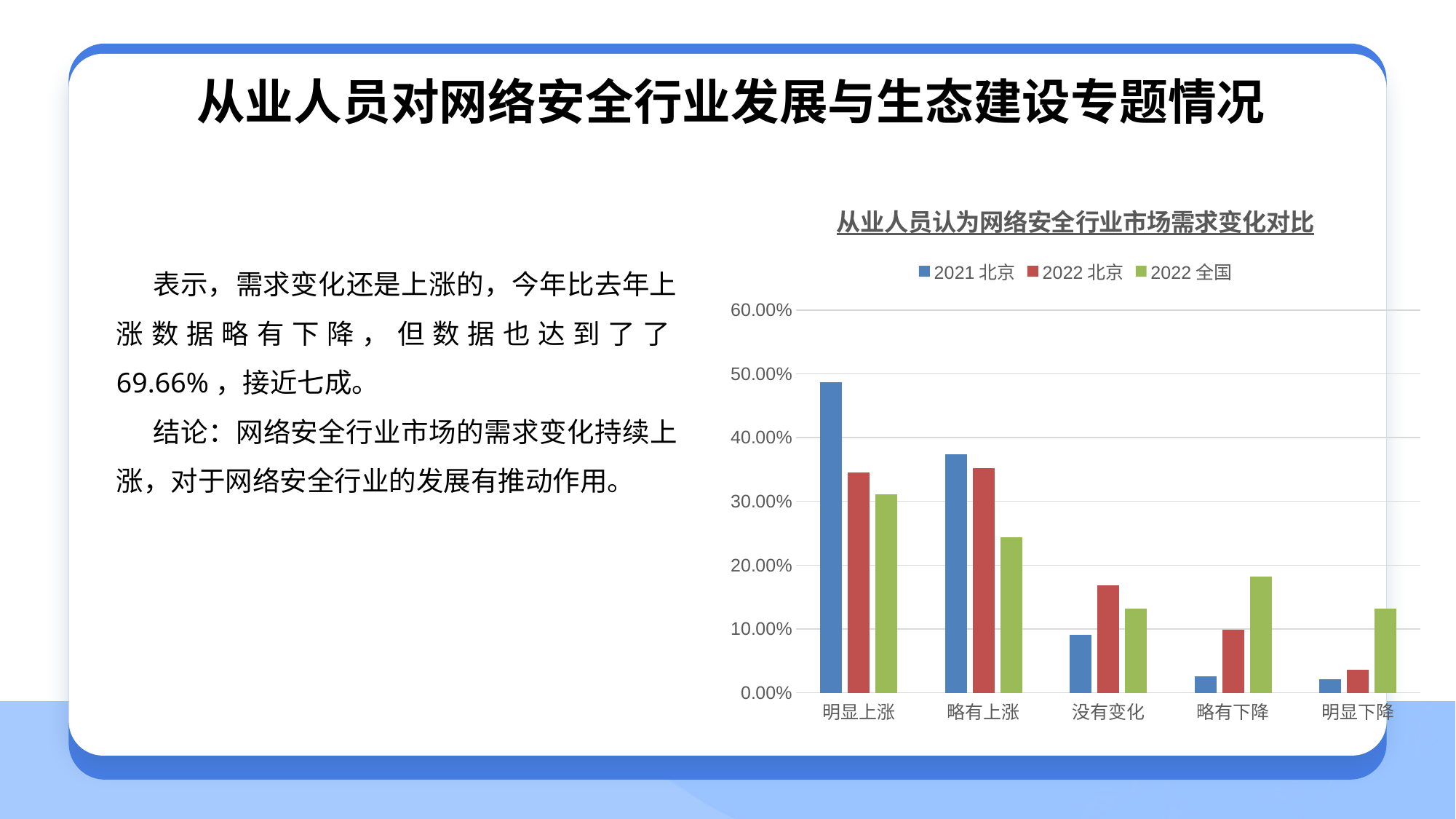
For the category 明显上涨, which series has the larger value: 2021 北京 or 2022 北京? 2021 北京 For the category 略有下降, which series has the larger value: 2021 北京 or 2022 全国? 2022 全国 What kind of chart is shown on the slide? bar chart What is the title of the chart? 从业人员认为网络安全行业市场需求变化对比 Is the value for 明显上涨 in the 2021 北京 series greater or less than 40.00%? greater How many series does the chart's legend list? 3 Is the value for 略有下降 in the 2021 北京 series greater or less than 10.00%? less Which category has the highest value for the 2021 北京 series? 明显上涨 Is the value for 略有上涨 in the 2022 全国 series greater or less than 30.00%? less How many categories are shown on the x axis of the chart? 5 Do the values of the 2021 北京 series rise or fall from left to right along the x axis? fall Which category has the lowest value for the 2022 北京 series? 明显下降